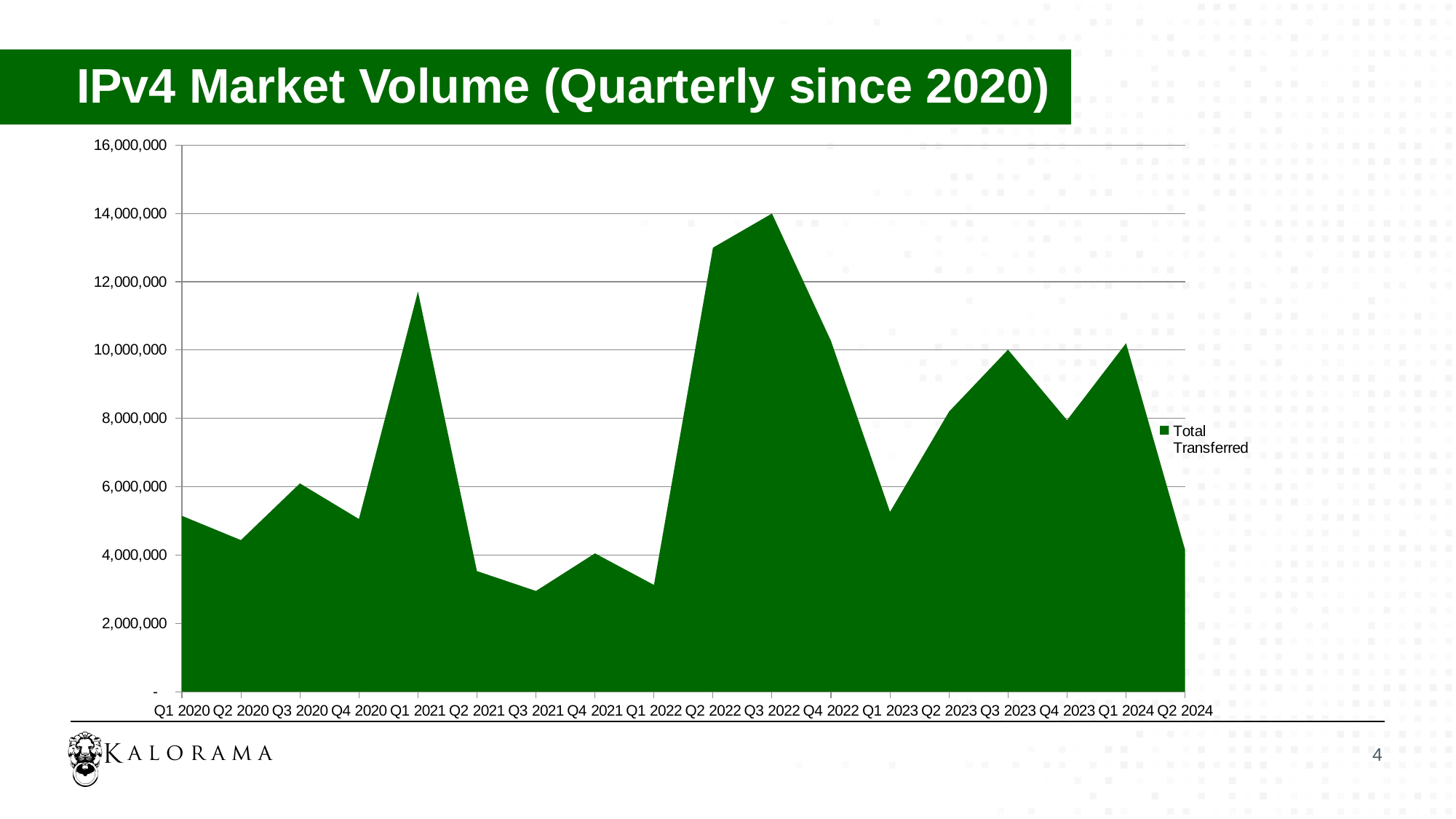
What is the name of the series shown in the legend? Total Transferred What kind of chart is shown on the slide? Area chart Is the value for Q3 2021 greater or less than 4,000,000? less Do the values rise or fall from Q3 2022 to Q1 2023? fall How many series does the legend list? 1 What is the title of the chart? IPv4 Market Volume (Quarterly since 2020) Is the value for Q1 2021 greater or less than 10,000,000? greater Which is larger, the value for Q1 2021 or the value for Q3 2020? Q1 2021 Is the value for Q2 2024 greater or less than 6,000,000? less Which quarter has the highest total transferred? Q3 2022 How many quarters are plotted along the x axis? 18